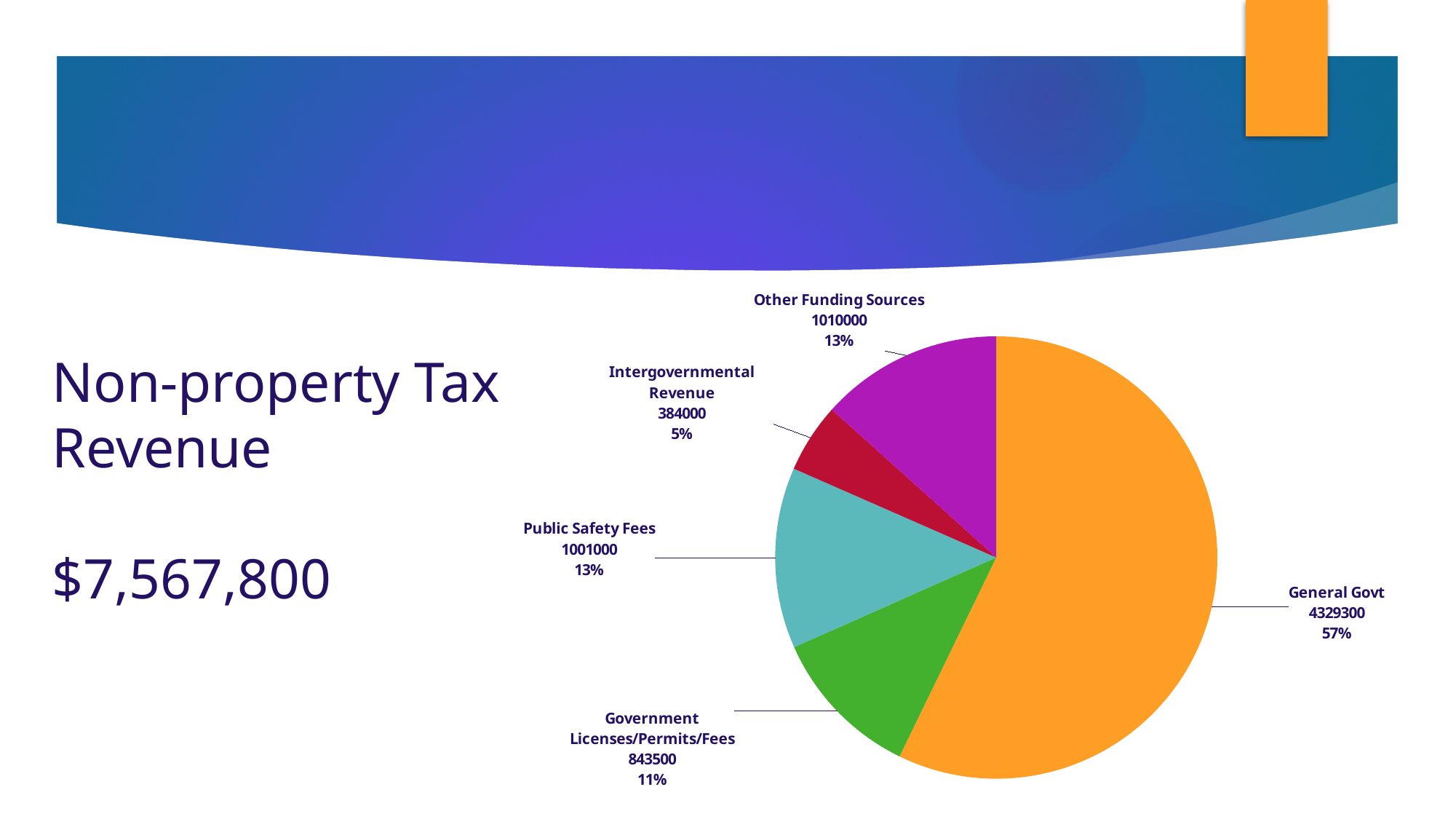
How many slices does the pie chart have? 5 What is the value for Public Safety Fees? 1001000 What is the value for General Govt? 4329300 What is the value for Intergovernmental Revenue? 384000 Which category has the smallest slice? Intergovernmental Revenue What share of the pie does General Govt represent? 57% What share of the pie does Other Funding Sources represent? 13% Which is larger, the value for Public Safety Fees or the value for Government Licenses/Permits/Fees? Public Safety Fees What is the difference between the values for General Govt and Public Safety Fees? 3328300 What type of chart is shown on the slide? pie chart What is the value for Government Licenses/Permits/Fees? 843500 Which category has the largest slice? General Govt